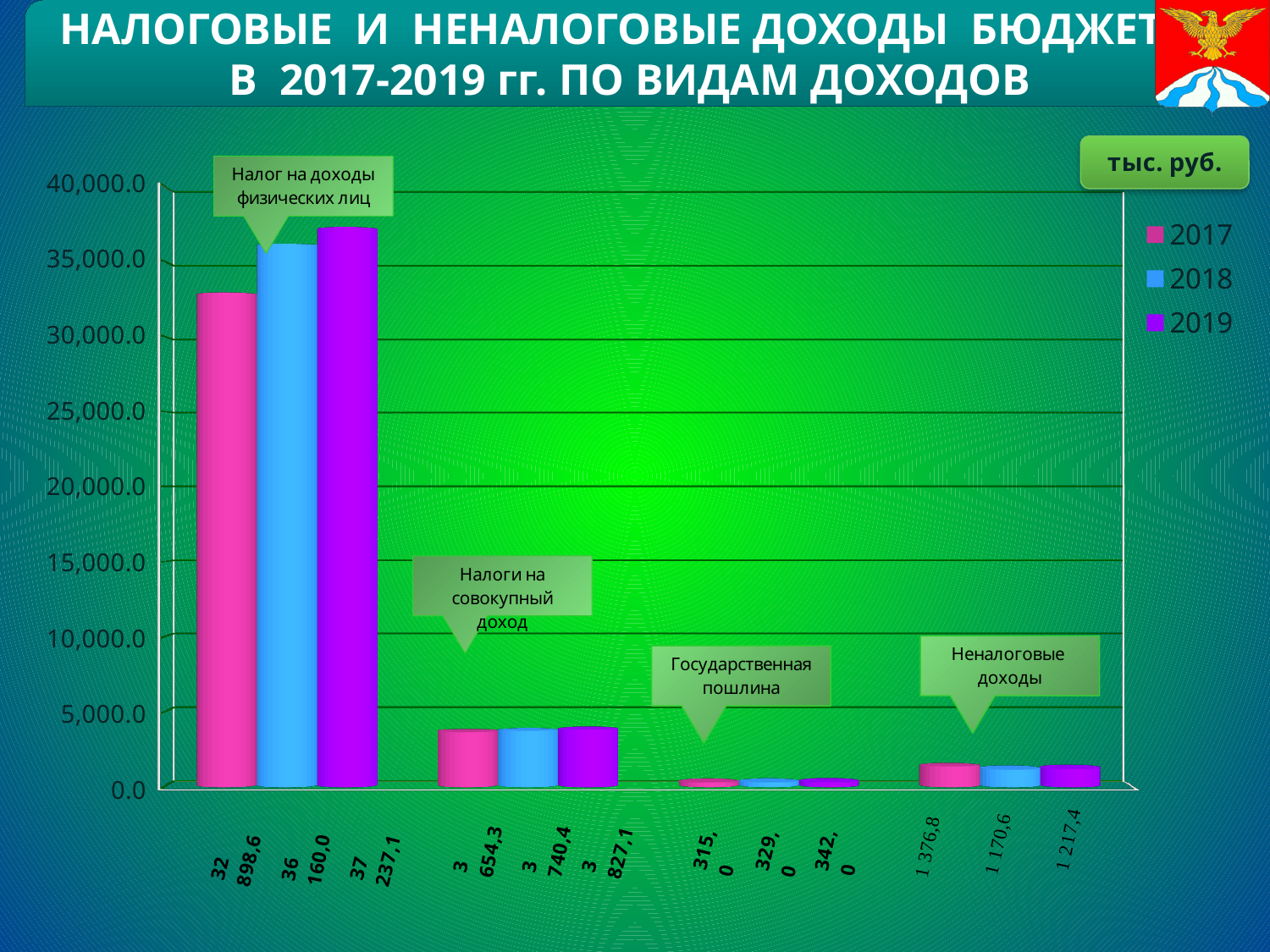
How many income categories are shown on the chart? 4 Which income category has the lowest values on the chart? Государственная пошлина Is the 2018 value for Налог на доходы физических лиц greater or less than 35,000.0? greater What kind of chart is shown on the slide? bar chart How many series does the legend list? 3 What is the difference between the 2018 and 2017 values for Налоги на совокупный доход? 86,1 What is the 2017 value for Налог на доходы физических лиц? 32 898,6 What is the 2018 value for Государственная пошлина? 329,0 By how much did Налог на доходы физических лиц increase from 2017 to 2019? 4 338,5 What is the 2019 value for Неналоговые доходы? 1 217,4 For Неналоговые доходы, which year has the larger value, 2017 or 2018? 2017 Which income category has the highest values on the chart? Налог на доходы физических лиц